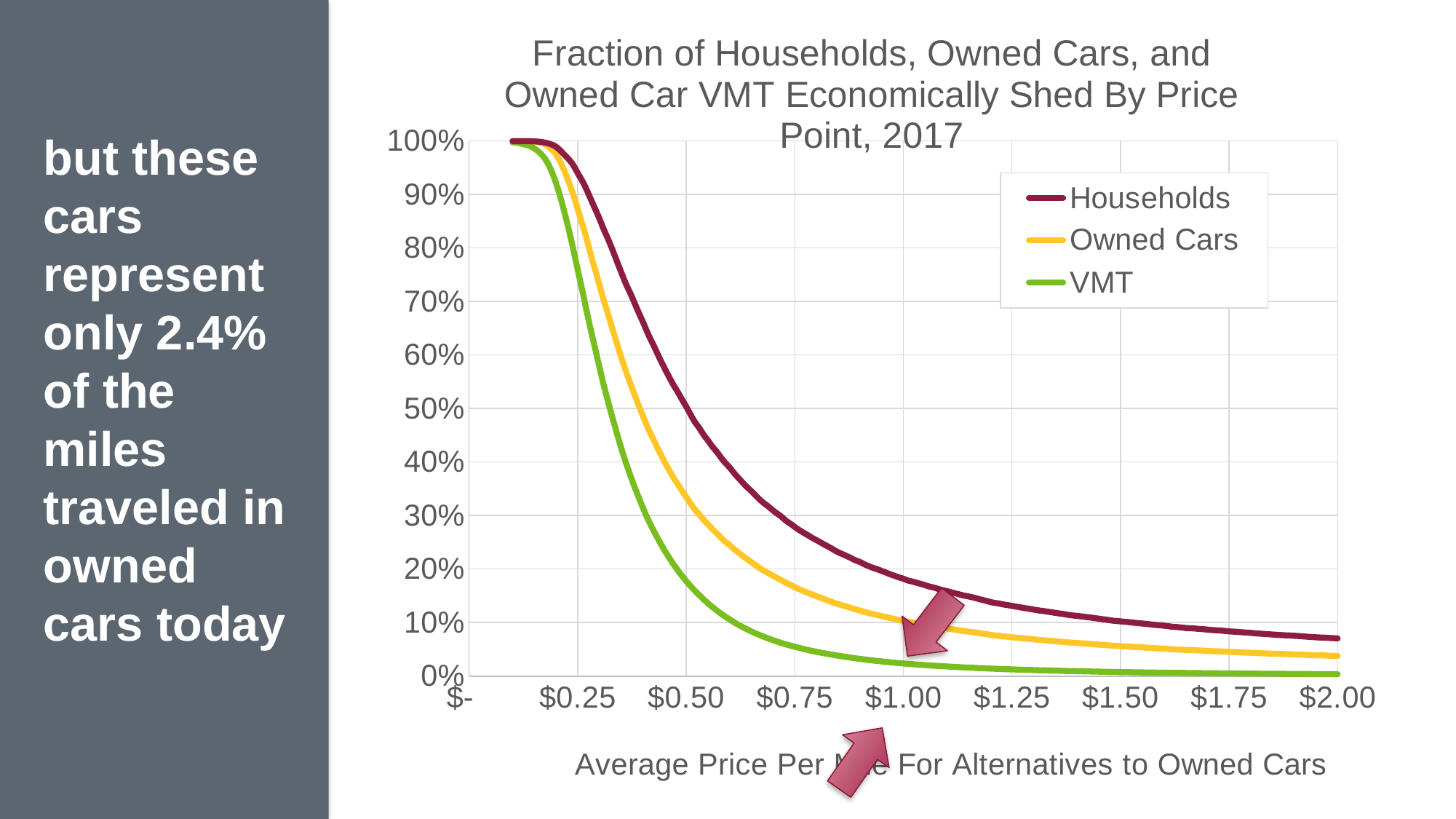
Do the values of the VMT series rise or fall as the price per mile increases? fall At $1.00, which is larger: the Households value or the VMT value? Households At $0.50, which is larger: the Owned Cars value or the VMT value? Owned Cars Is the value for Households at $2.00 greater or less than 10%? less What kind of chart is shown on the slide? line chart How many series does the legend list? 3 Which series has the highest value at $1.00? Households Is the value for Households at $1.25 greater or less than 10%? greater Is the value for VMT at $1.00 greater or less than 10%? less Which series has the lowest value at $1.00? VMT Which series are listed in the legend? Households, Owned Cars, VMT What is the x-axis label of the chart? Average Price Per Mile For Alternatives to Owned Cars